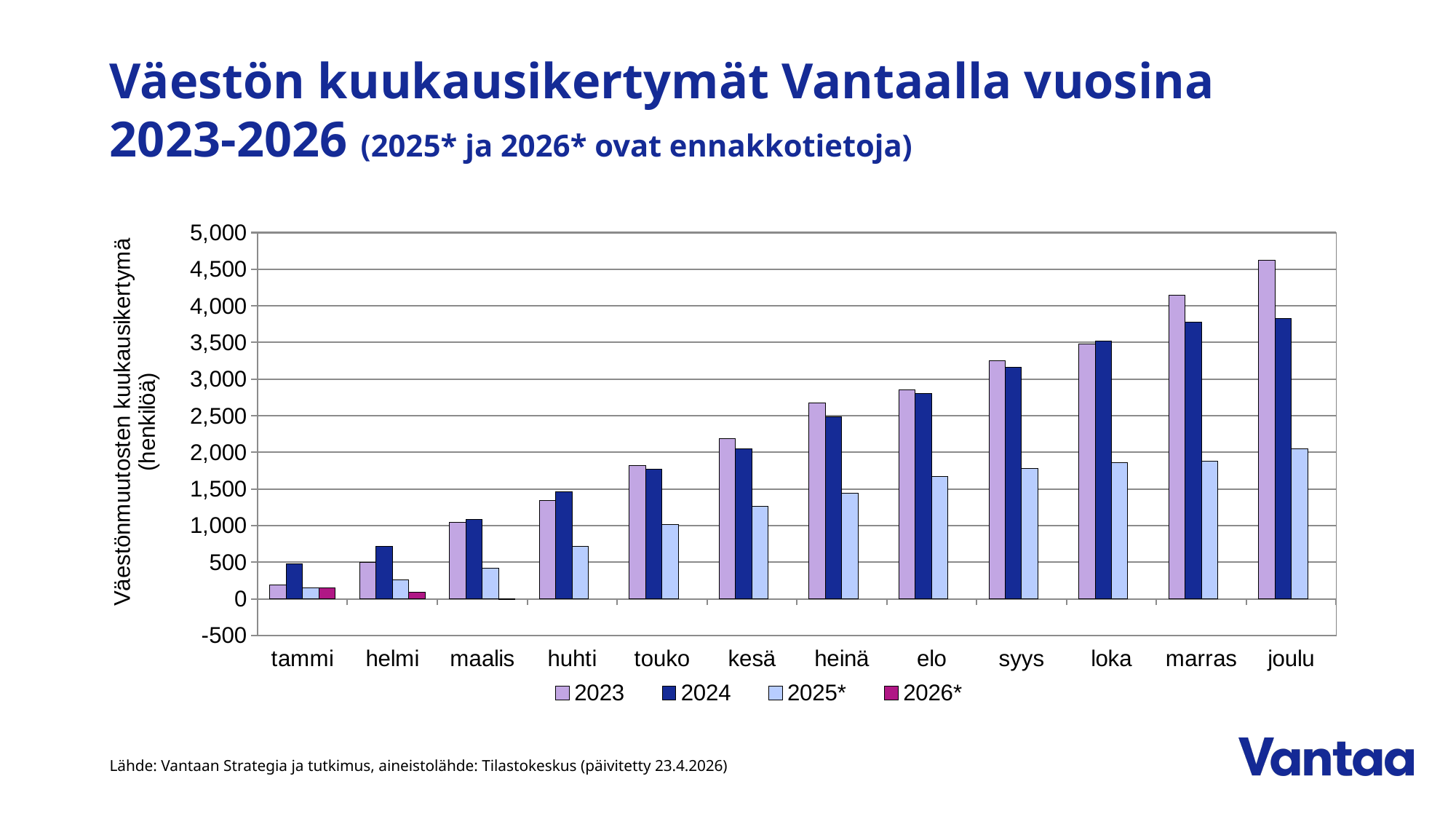
What is the title of the y axis? Väestönmuutosten kuukausikertymä (henkilöä) What kind of chart is shown on the slide? bar chart How many series does the legend list? 4 For the 2025* series, which month has the lowest value? tammi Is the value for 2024 in joulu greater or less than 4,000? less In tammi, which series has the larger value, 2023 or 2024? 2024 Is the value for 2023 in joulu greater or less than 4,000? greater For the 2023 series, which month has the highest value? joulu Do the values for the 2025* series rise or fall from tammi to joulu? rise In marras, which series has the larger value, 2023 or 2024? 2023 Is the value for 2025* in joulu greater or less than 1,500? greater How many months are shown on the x axis? 12